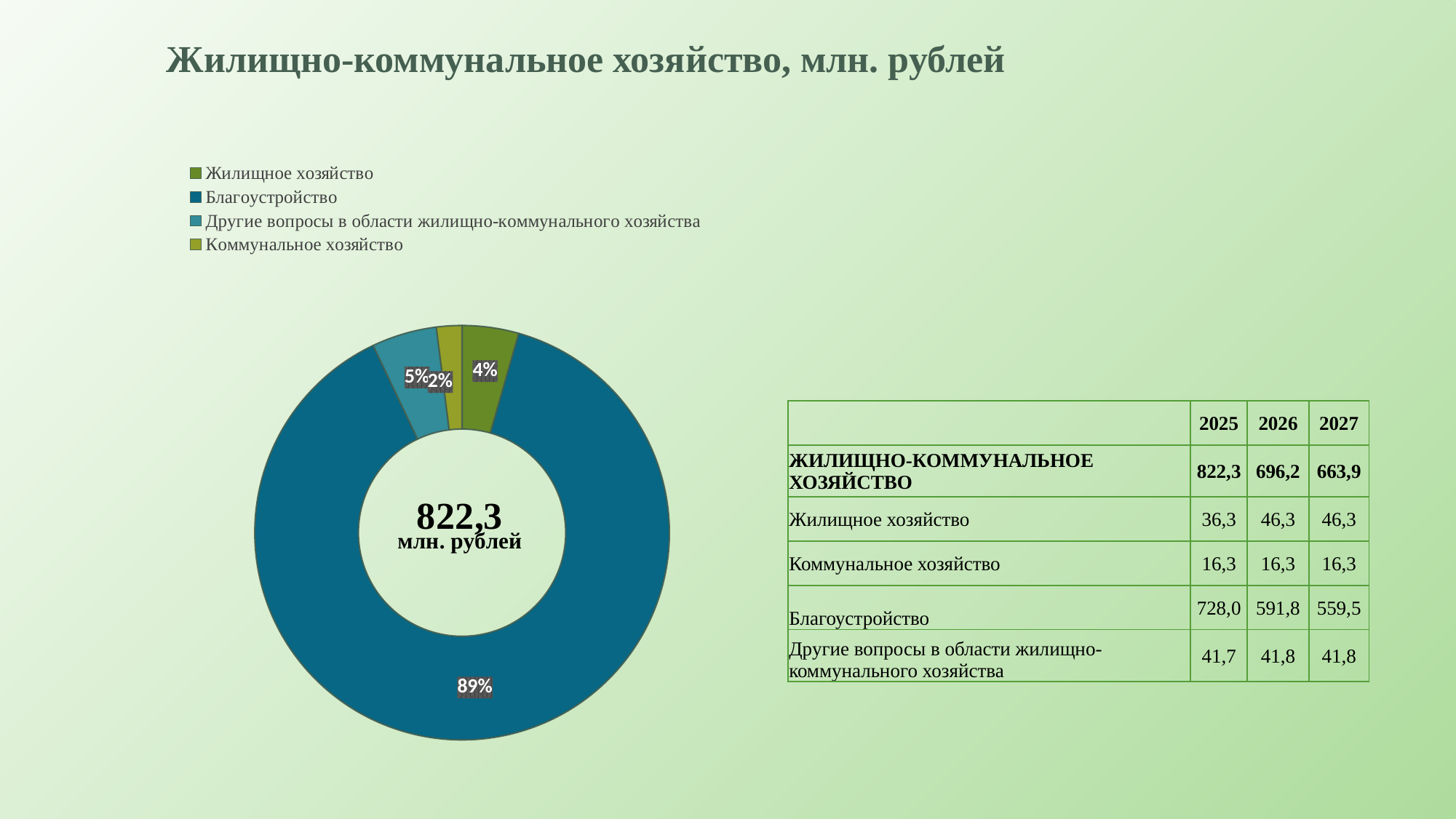
What share of the doughnut chart does Другие вопросы в области жилищно-коммунального хозяйства take? 5% Which slice is larger in the doughnut chart: Жилищное хозяйство or Другие вопросы в области жилищно-коммунального хозяйства? Другие вопросы в области жилищно-коммунального хозяйства What kind of chart is shown on the slide? doughnut chart What is the title of the slide with the doughnut chart? Жилищно-коммунальное хозяйство, млн. рублей What share of the doughnut chart does Жилищное хозяйство take? 4% What total value is printed in the centre of the doughnut chart? 822,3 млн. рублей What share of the doughnut chart does Благоустройство take? 89% How many slices does the doughnut chart have? 4 How many entries does the legend of the doughnut chart list? 4 Which category has the smallest slice in the doughnut chart? Коммунальное хозяйство Which category has the largest slice in the doughnut chart? Благоустройство